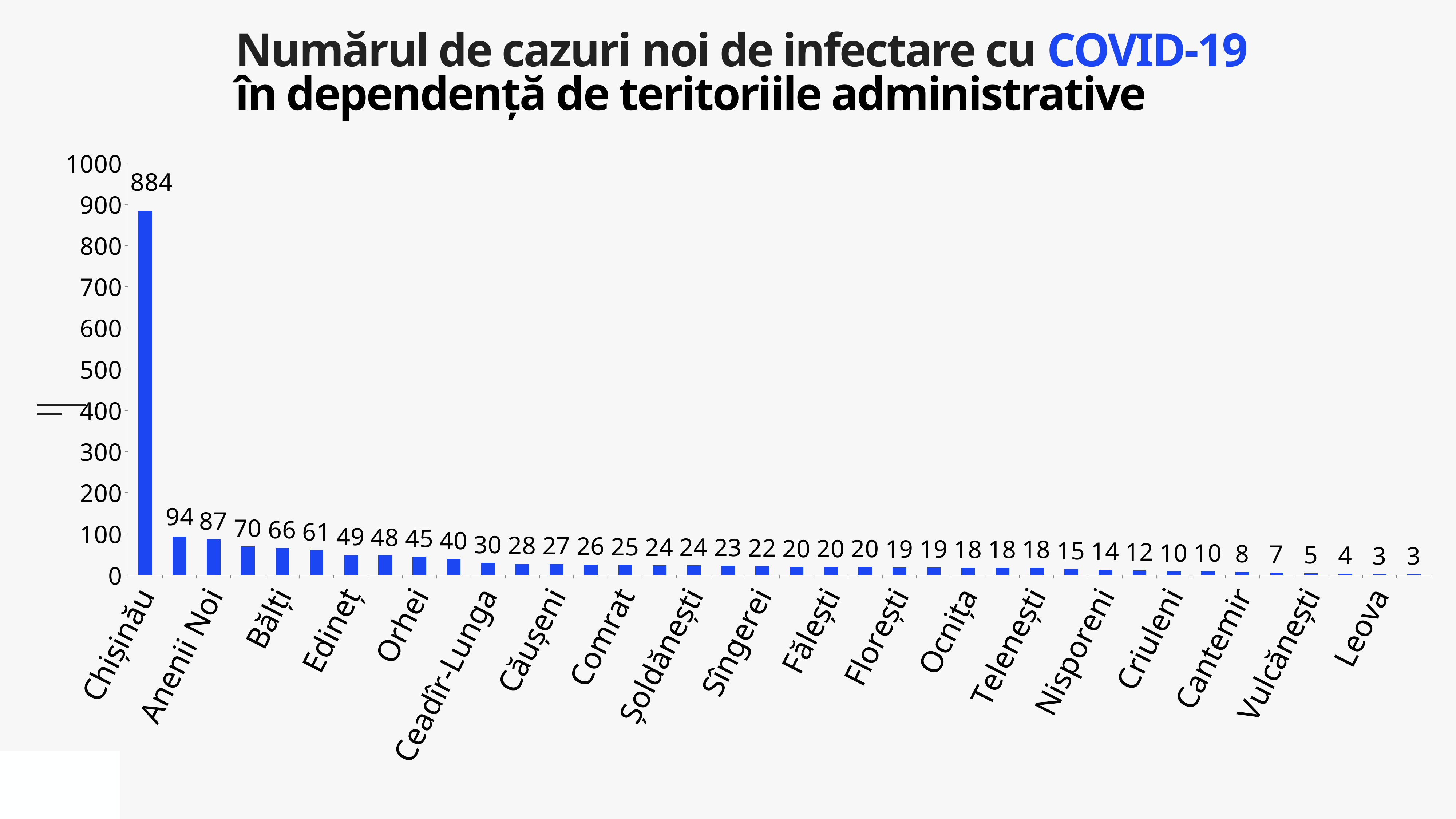
Which territory has the highest number of new cases? Chișinău What kind of chart is shown on the slide? bar chart What is the difference between the values for Chișinău and Anenii Noi? 797 What is the title of the chart? Numărul de cazuri noi de infectare cu COVID-19 în dependență de teritoriile administrative Is the value for Chișinău greater or less than 800? greater What is the value for Leova? 3 What is the value for Orhei? 45 What is the value for Chișinău? 884 Do the values rise or fall from left to right along the x axis? fall What is the value for Bălți? 66 Which is larger, the value for Chișinău or the value for Bălți? Chișinău What is the value for Anenii Noi? 87